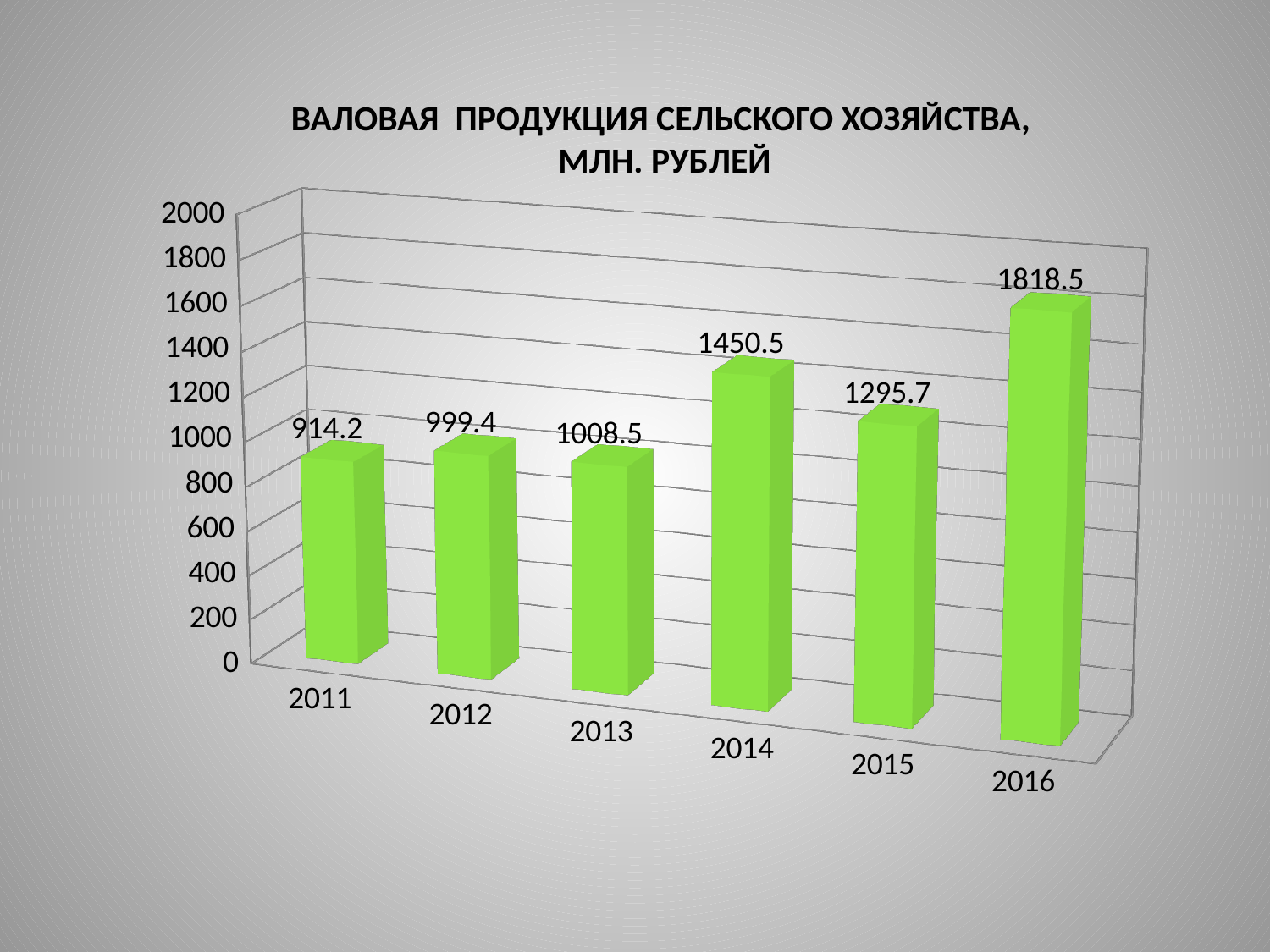
What is the difference between the values for 2014 and 2013? 442 What is the title of the chart? ВАЛОВАЯ ПРОДУКЦИЯ СЕЛЬСКОГО ХОЗЯЙСТВА, МЛН. РУБЛЕЙ Is the value for 2012 greater or less than 1200? less What kind of chart is shown on the slide? bar chart What is the value for 2011? 914.2 Which is larger, the value for 2014 or the value for 2015? 2014 What is the value for 2014? 1450.5 How many years are shown on the chart? 6 Which year has the lowest value? 2011 What is the difference between the values for 2016 and 2015? 522.8 Which year has the highest value? 2016 What is the value for 2016? 1818.5